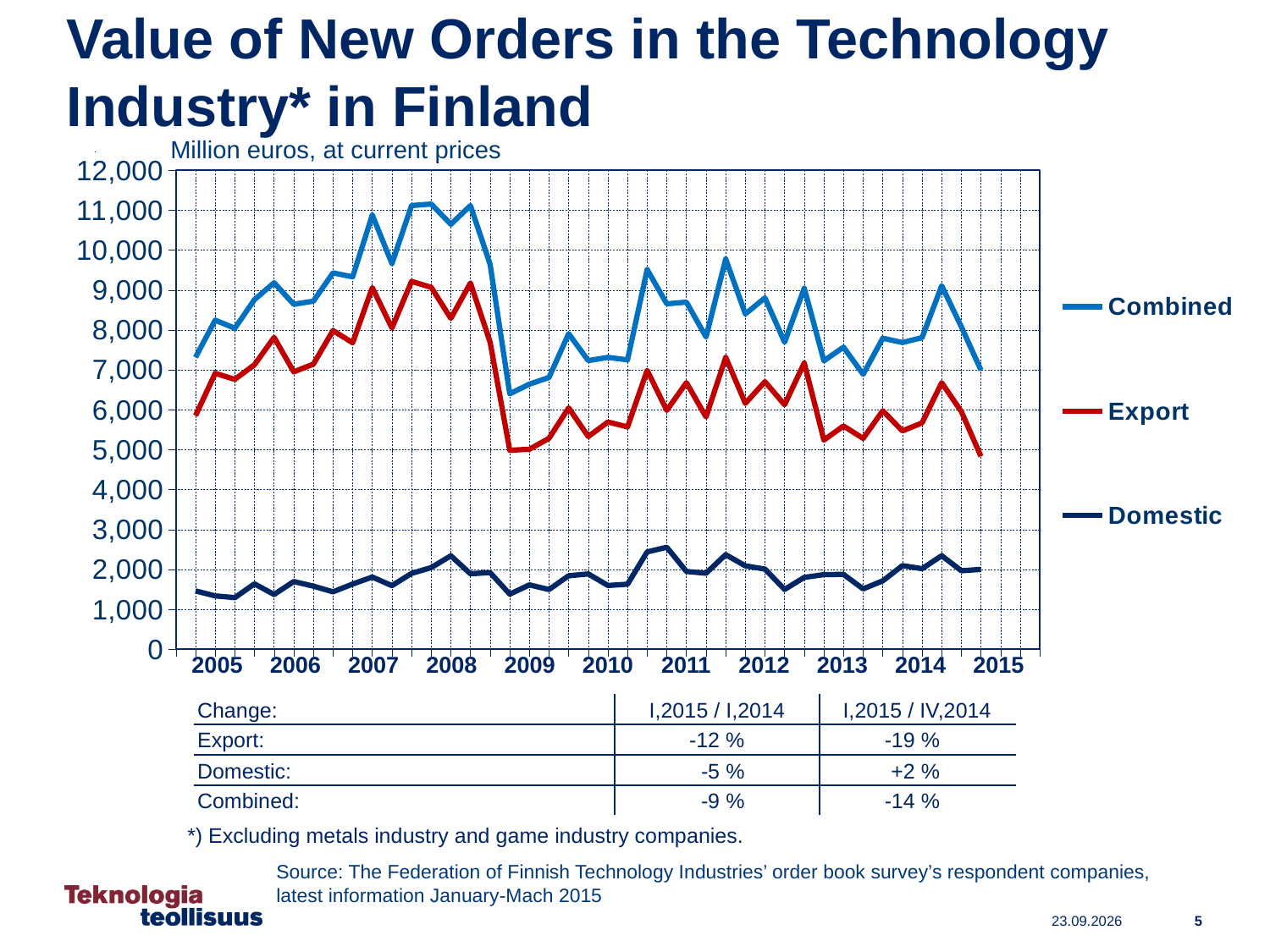
Is the Domestic series ever greater or less than 3,000? less Is the Combined value in early 2009 greater or less than 7,000? less Which is larger in 2012, the Export series or the Domestic series? Export Which series has the highest values throughout the chart? Combined What are the three series named in the legend? Combined, Export, Domestic How many year labels are shown on the x axis? 11 Which series has the lowest values throughout the chart? Domestic What unit is stated above the chart? Million euros, at current prices What kind of chart is shown on the slide? line chart Is the peak value of the Combined series in 2008 greater or less than 10,000? greater How many series does the legend list? 3 Does the Export series rise or fall between 2014 and 2015? fall